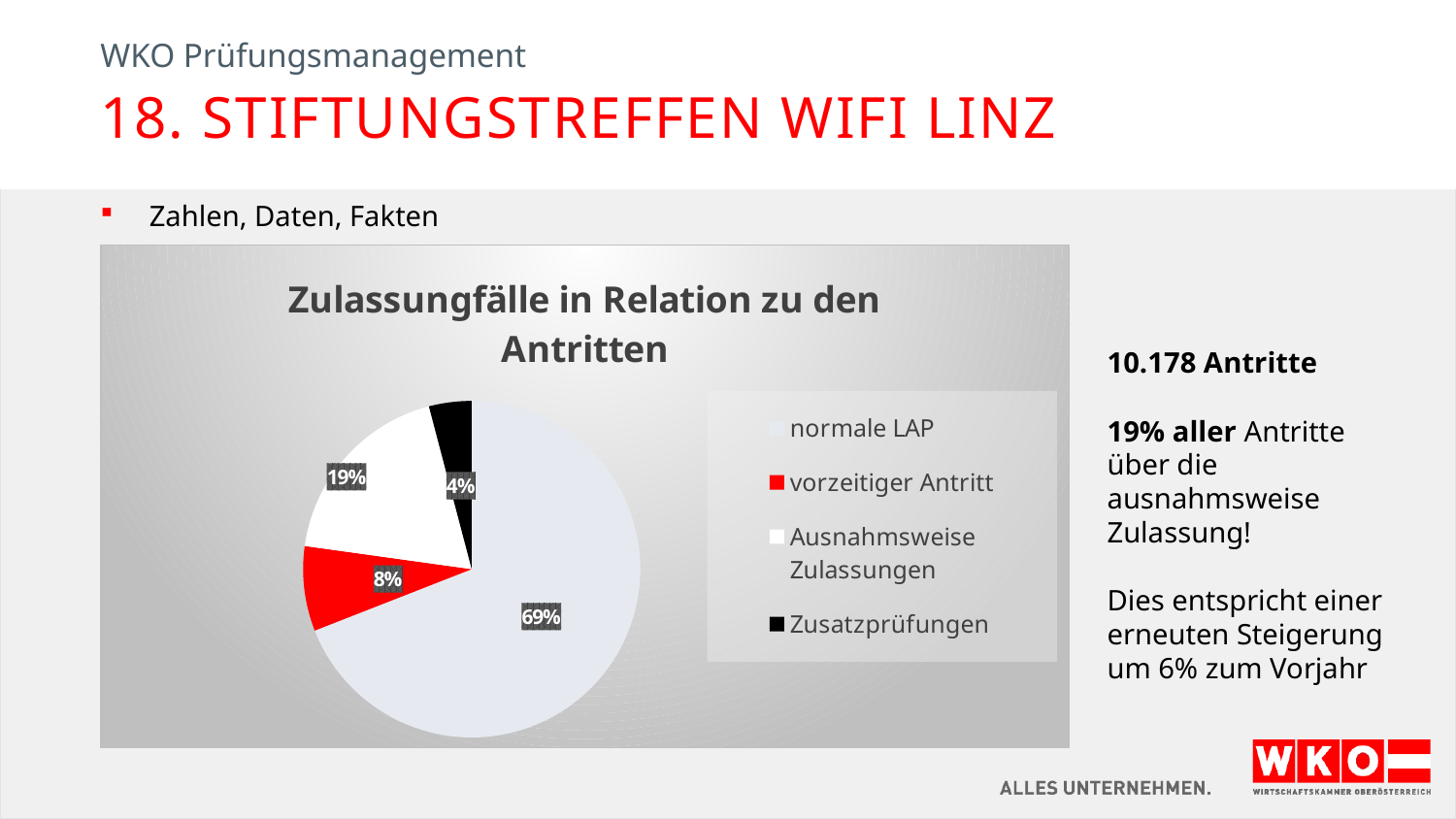
How many slices does the pie chart have? 4 What share of the pie does "Ausnahmsweise Zulassungen" represent? 19% What is the difference in percentage points between "normale LAP" and "Ausnahmsweise Zulassungen"? 50 Which category has the smallest slice of the pie? Zusatzprüfungen What is the title of the chart? Zulassungfälle in Relation zu den Antritten Which category has the largest slice of the pie? normale LAP What type of chart is shown on the slide? pie chart Which is larger, the slice for "vorzeitiger Antritt" or the slice for "Zusatzprüfungen"? vorzeitiger Antritt What share of the pie does "Zusatzprüfungen" represent? 4% Which colour represents "vorzeitiger Antritt" in the pie chart? red What share of the pie does "normale LAP" represent? 69%